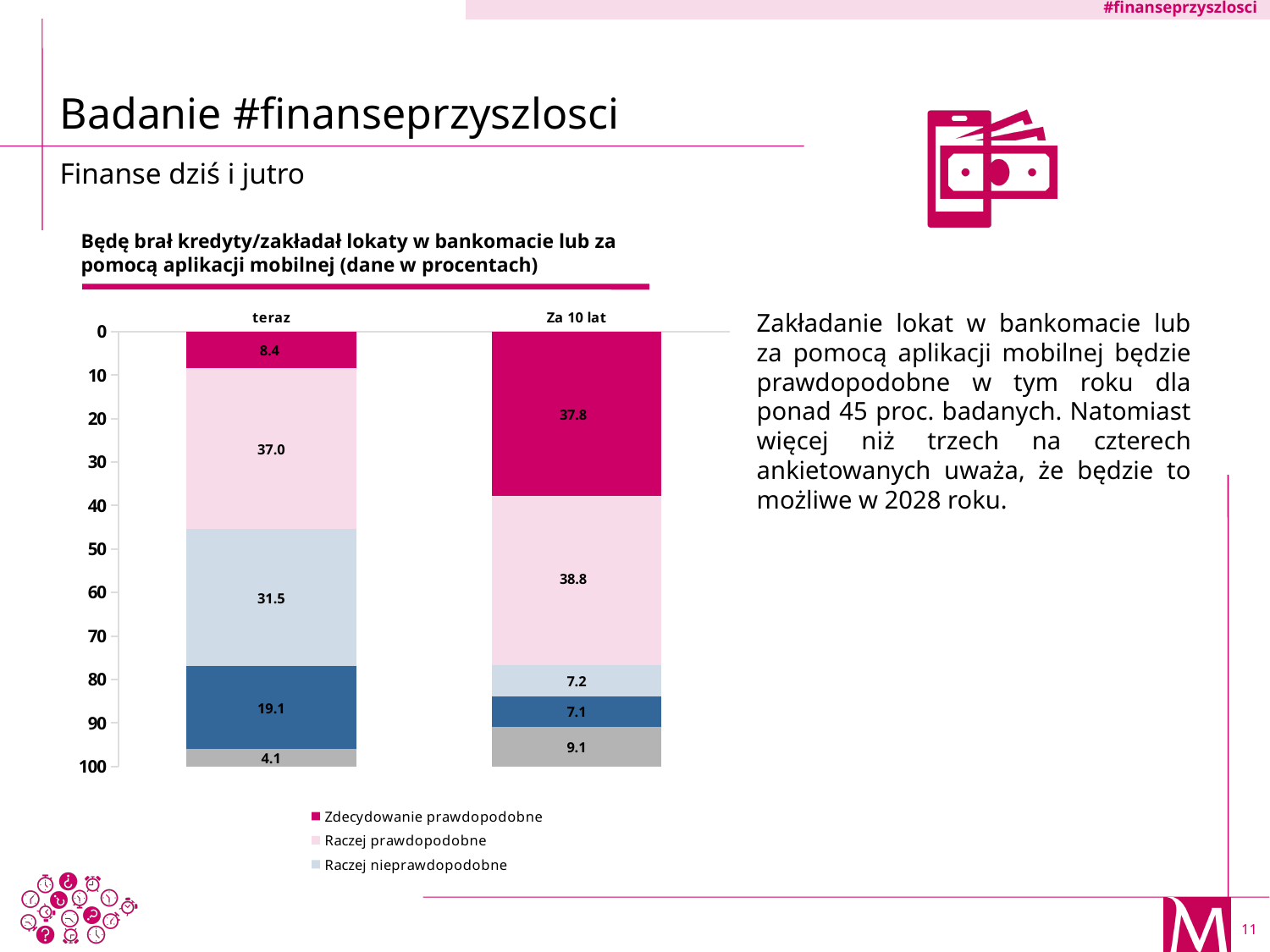
What type of chart is shown on the slide? Stacked bar chart What is the difference between the "Zdecydowanie prawdopodobne" values for "Za 10 lat" and "teraz"? 29.4 Which category has the larger "Raczej prawdopodobne" value, "teraz" or "Za 10 lat"? Za 10 lat What is the value of "Raczej prawdopodobne" for "teraz"? 37.0 How many series does the chart legend list? 3 What is the difference between the "Raczej nieprawdopodobne" values for "teraz" and "Za 10 lat"? 24.3 What is the title of the chart? Będę brał kredyty/zakładał lokaty w bankomacie lub za pomocą aplikacji mobilnej (dane w procentach) What is the value of "Raczej nieprawdopodobne" for "Za 10 lat"? 7.2 What is the total of all segments in the "teraz" bar? 100.1 What is the value of "Zdecydowanie prawdopodobne" for "teraz"? 8.4 What is the value of "Zdecydowanie prawdopodobne" for "Za 10 lat"? 37.8 How many categories are shown on the x axis of the chart? 2